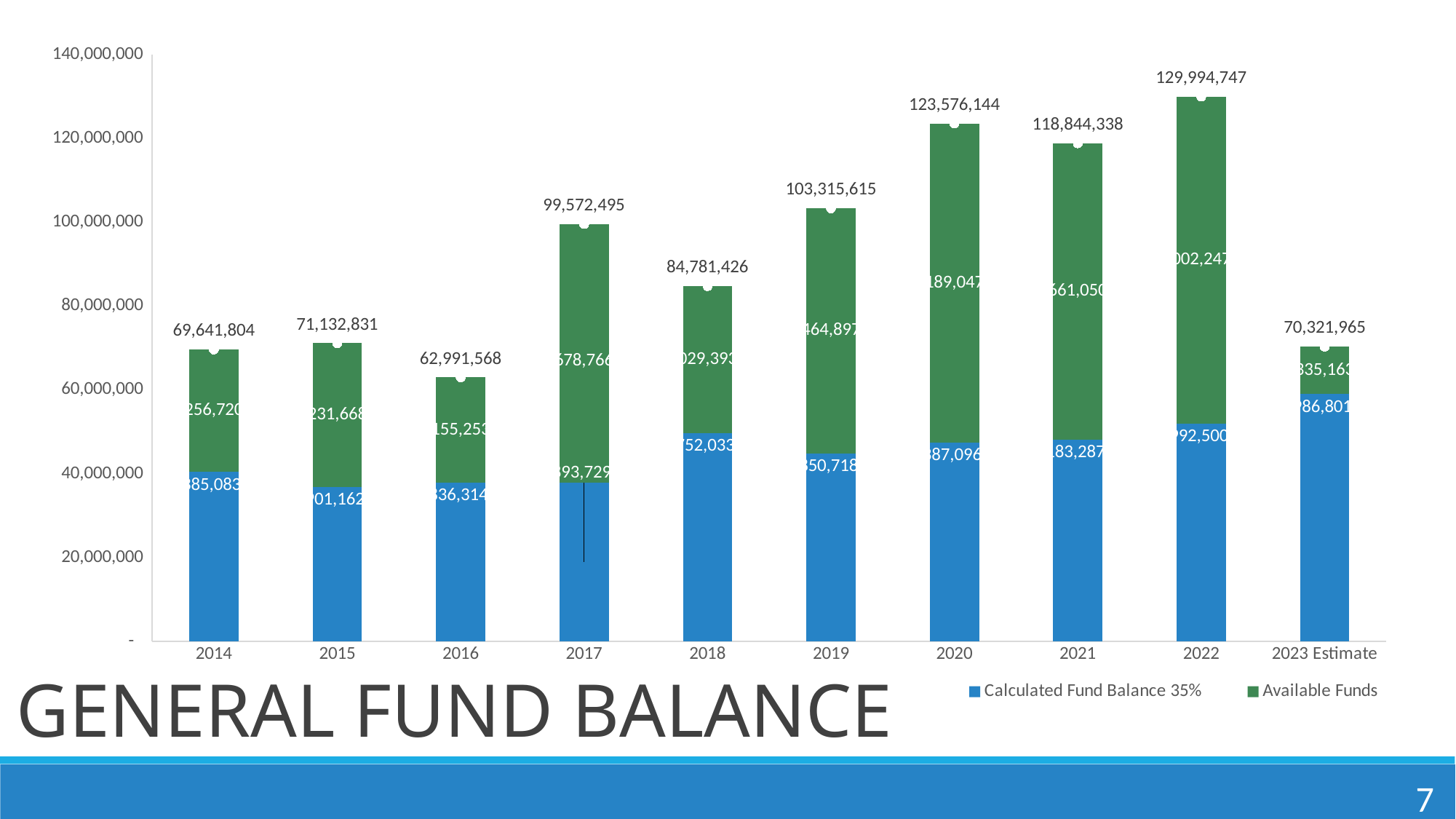
How many series does the legend list? 2 How many years (categories) are shown on the x axis? 10 Which year has the lowest total bar? 2016 What is the total general fund balance shown for 2022? 129,994,747 What is the total value labelled above the 2016 bar? 62,991,568 What is the total value shown for the 2023 Estimate? 70,321,965 What kind of chart is shown on the slide? Stacked bar chart What is the difference between the 2022 total and the 2021 total? 11,150,409 What is the difference between the 2020 total and the 2019 total? 20,260,529 Which total is larger, 2017 or 2018? 2017 Is the Calculated Fund Balance 35% value for 2022 greater or less than 40,000,000? greater Which year has the highest total bar? 2022